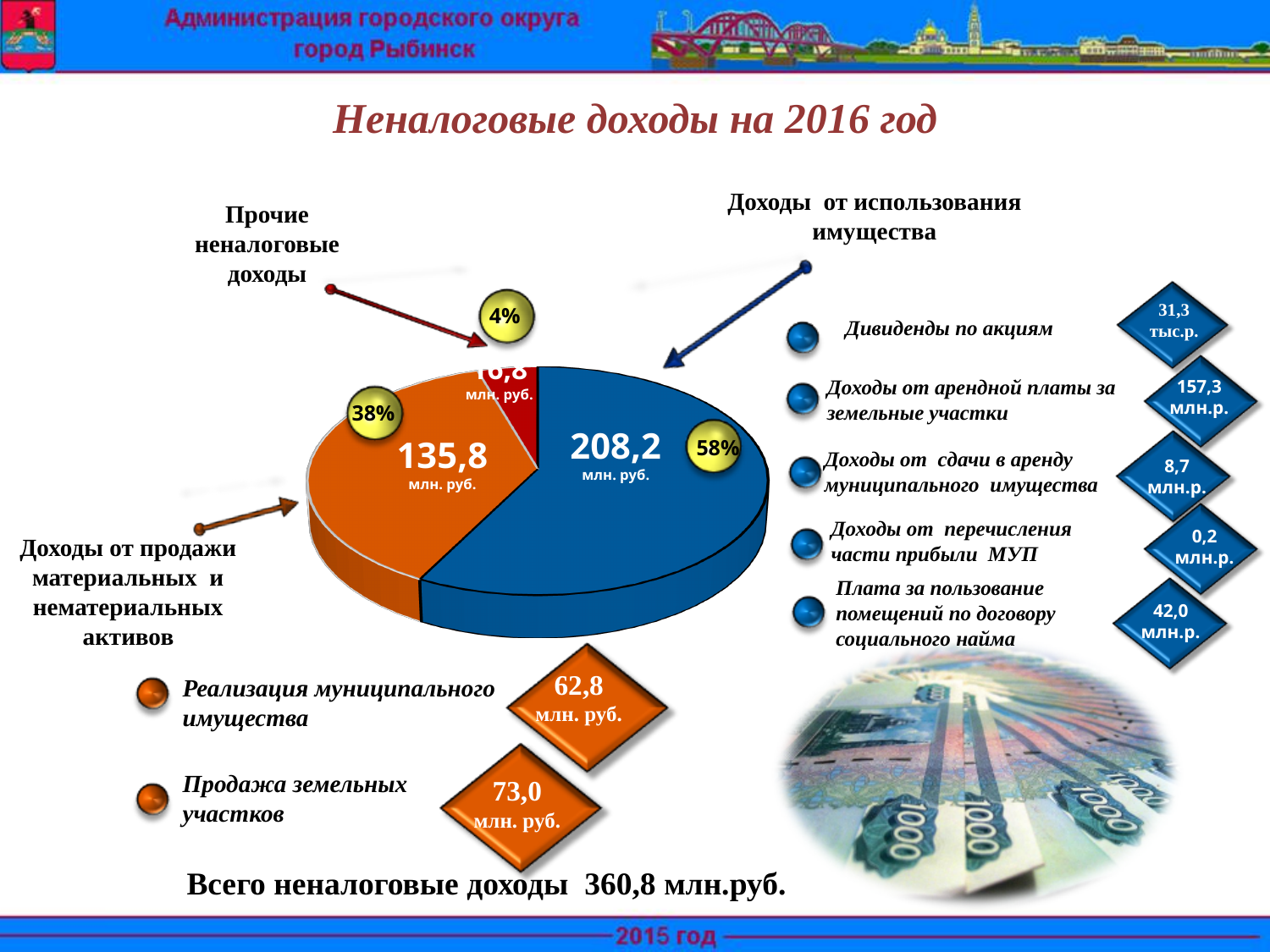
What is the value shown for the slice 'Доходы от использования имущества'? 208,2 млн. руб. How many slices does the pie chart have? 3 What kind of chart is shown on the slide? pie chart What is the value shown for the slice 'Доходы от продажи материальных и нематериальных активов'? 135,8 млн. руб. What is the difference in млн. руб. between 'Доходы от использования имущества' (208,2) and 'Доходы от продажи материальных и нематериальных активов' (135,8)? 72,4 млн. руб. Which slice of the pie chart is the largest? Доходы от использования имущества What share of the pie does 'Прочие неналоговые доходы' represent? 4% What is the title of the slide containing the pie chart? Неналоговые доходы на 2016 год Which is larger: 'Доходы от использования имущества' or 'Доходы от продажи материальных и нематериальных активов'? Доходы от использования имущества What share of the pie does 'Доходы от продажи материальных и нематериальных активов' represent? 38% What share of the pie does 'Доходы от использования имущества' represent? 58% Which slice of the pie chart is the smallest? Прочие неналоговые доходы